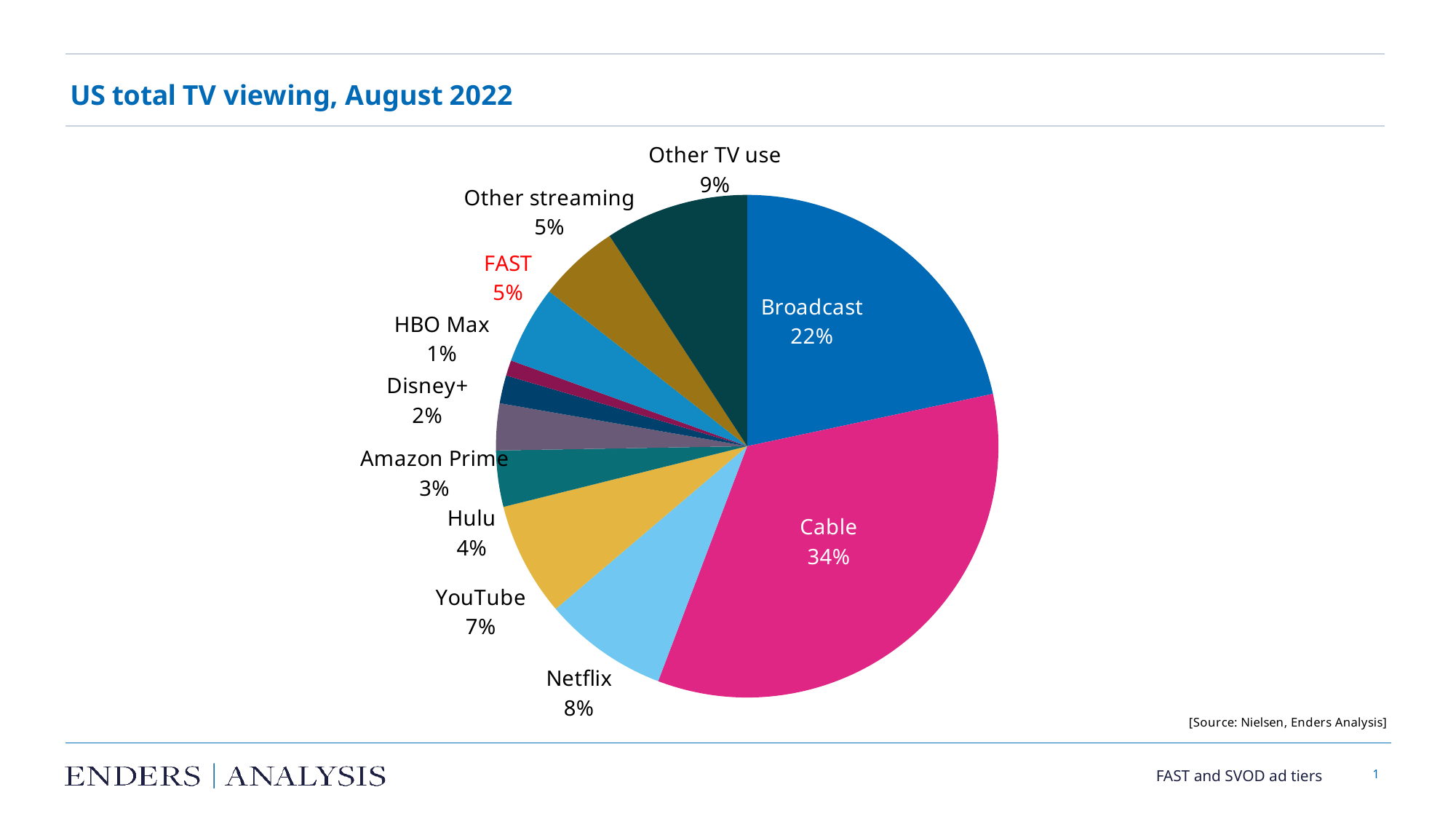
What share is shown for FAST? 5% What kind of chart is shown on the slide? Pie chart What percentage is shown for YouTube? 7% Which category has the largest share of the pie? Cable How many slices does the pie chart have? 11 What is the title of the chart? US total TV viewing, August 2022 Which category has the smallest share of the pie? HBO Max Which slice label is printed in red text? FAST Which is larger, the share for Hulu or the share for Amazon Prime? Hulu What is the value shown for Netflix? 8% What is the difference in percentage points between Cable and Broadcast? 12 What share of US total TV viewing does Cable account for? 34%